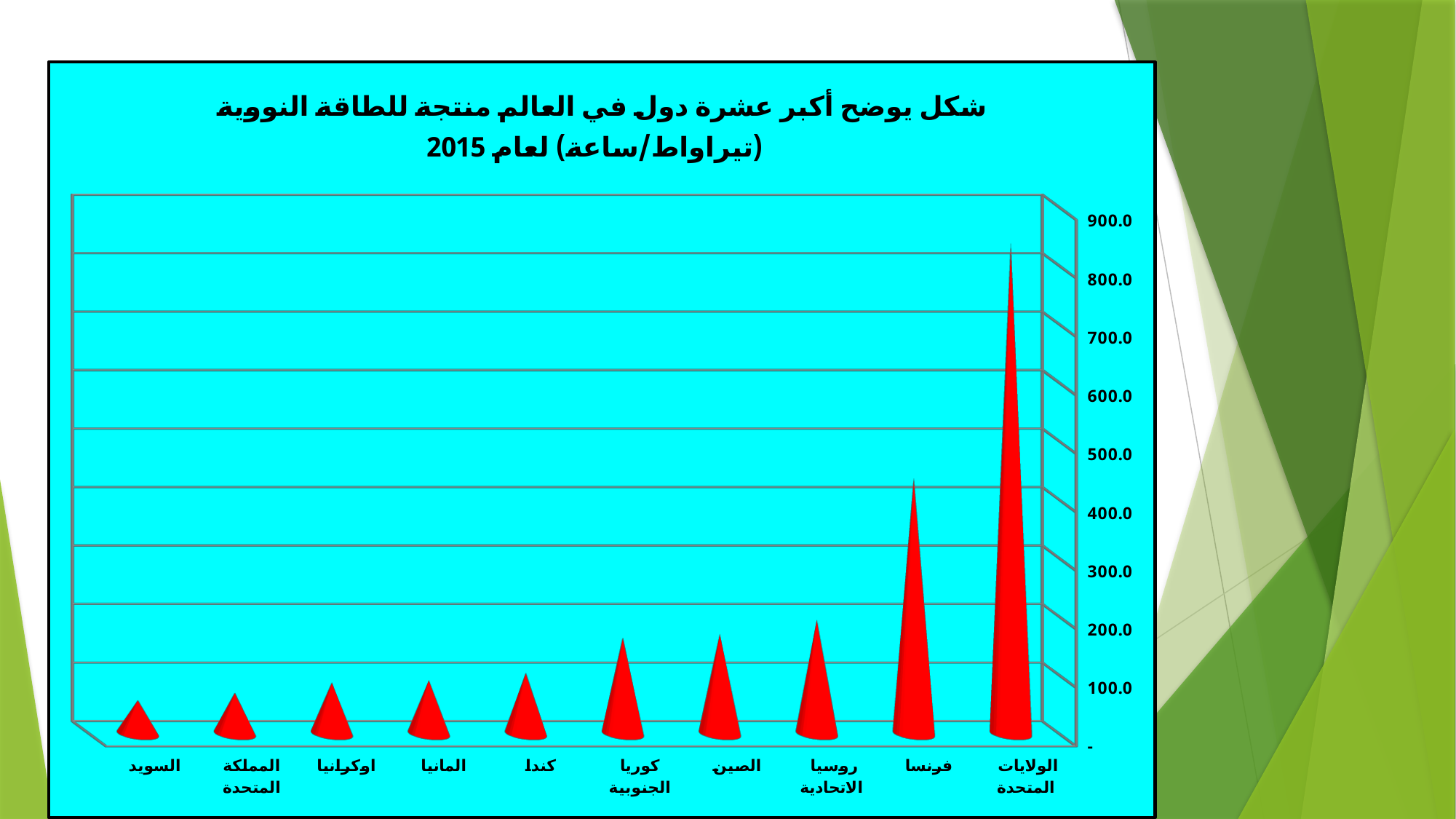
Is the value for روسيا الاتحادية greater or less than 300? less Which has a larger value, فرنسا or روسيا الاتحادية? فرنسا What kind of chart is shown on the slide? Bar chart What year does the chart title say the data is for? 2015 How many countries are plotted on the chart? 10 Is the value for السويد greater or less than 100? less Which country has the highest value on the chart? الولايات المتحدة Reading the categories from الولايات المتحدة on the right to السويد on the left, do the values rise or fall? fall Is the value for فرنسا greater or less than 400? greater Which country has the lowest value on the chart? السويد